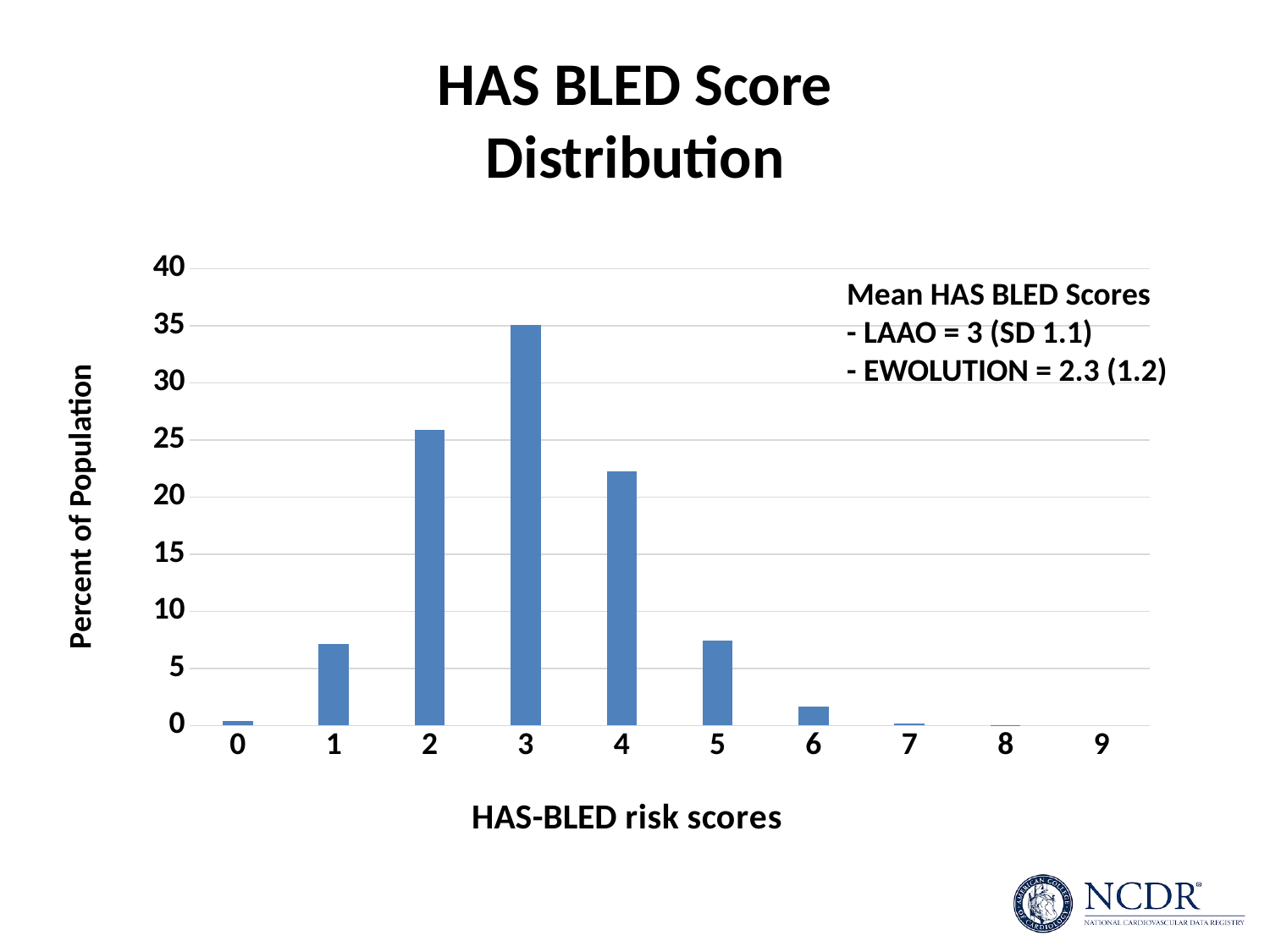
Do the values rise or fall from HAS-BLED risk score 3 to score 6? fall Which has a larger percent of population, HAS-BLED risk score 3 or score 5? 3 Which has a larger percent of population, HAS-BLED risk score 2 or score 4? 2 Is the value for HAS-BLED risk score 2 greater or less than 25? greater Is the value for HAS-BLED risk score 4 greater or less than 25? less What kind of chart is shown on the slide? bar chart Is the value for HAS-BLED risk score 1 greater or less than 10? less How many HAS-BLED risk score categories are shown on the x axis? 10 What is the label of the y axis? Percent of Population Which HAS-BLED risk score has the highest percent of population? 3